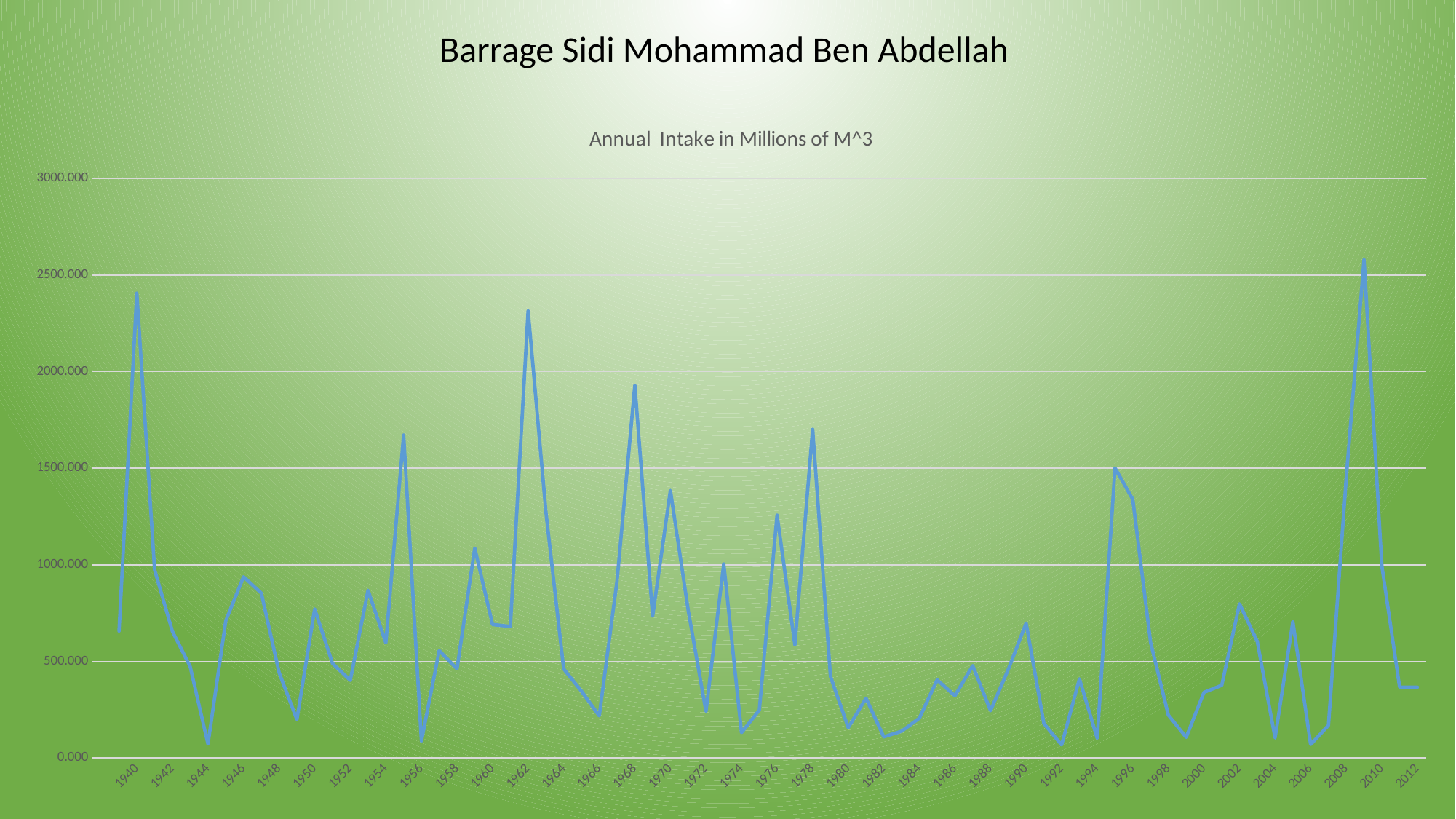
Is the value for 1962 greater or less than 2000.000? greater Is the value for 1978 greater or less than 1500.000? greater Is the value for 2012 greater or less than 500.000? less Which year has the larger value, 1962 or 1978? 1962 What kind of chart is shown on the slide? line chart What is the title of the chart? Barrage Sidi Mohammad Ben Abdellah What does the chart subtitle say is being plotted? Annual Intake in Millions of M^3 Which year has the larger value, 1940 or 1968? 1940